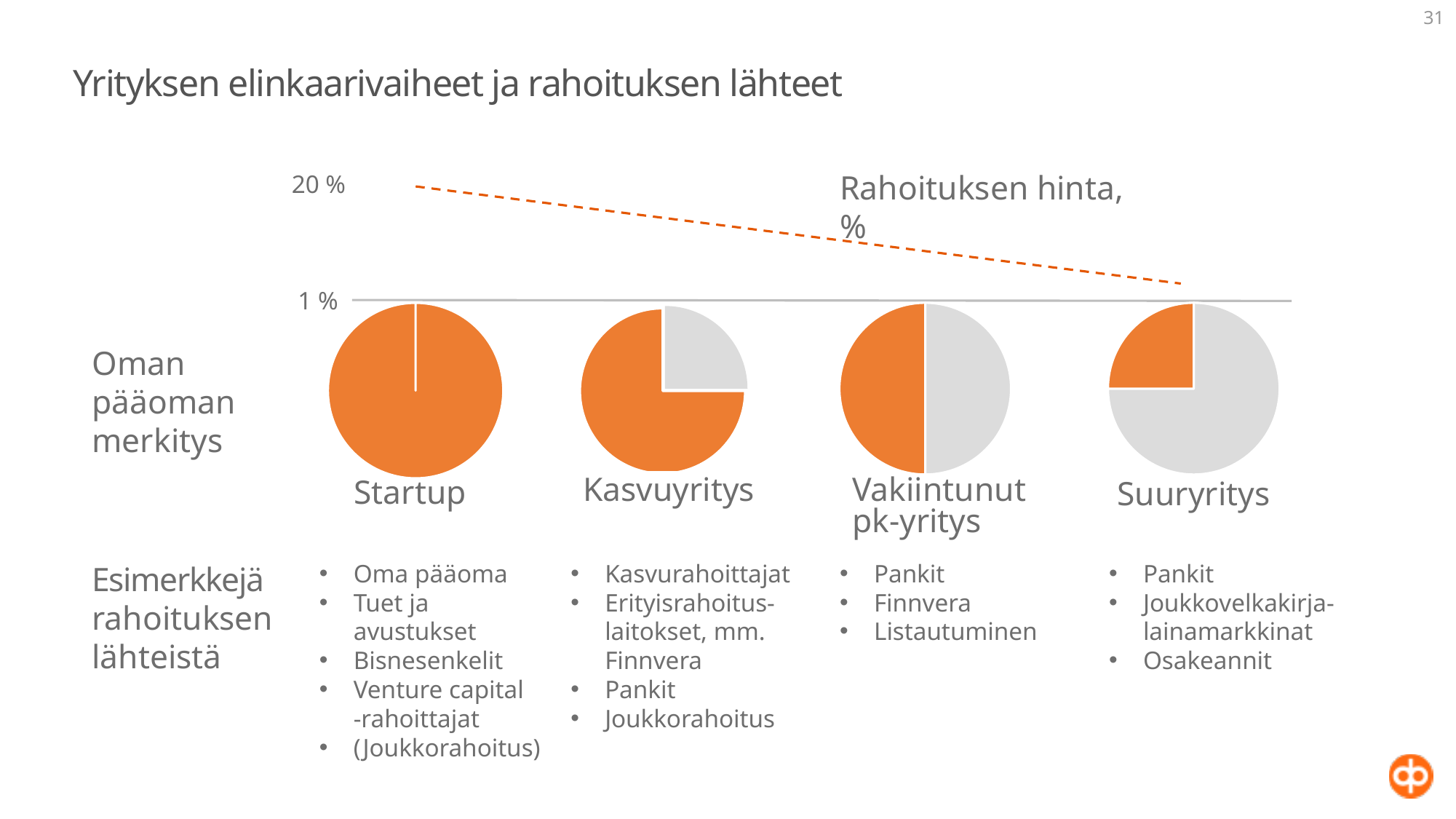
Does the dashed line labelled 'Rahoituksen hinta, %' rise or fall from left to right? Fall Which has a larger orange share in its pie chart, Suuryritys or Startup? Startup How many pie charts are shown on the slide? 4 What are the two percentage labels shown on the left of the dashed 'Rahoituksen hinta' line? 20 % and 1 % Is the orange share of the Suuryritys pie chart greater or less than half of the pie? less Is the orange share of the Kasvuyritys pie chart greater or less than half of the pie? greater What is the label of the third pie chart from the left? Vakiintunut pk-yritys Which has a larger orange share in its pie chart, Kasvuyritys or Vakiintunut pk-yritys? Kasvuyritys Which pie chart has the largest orange (own equity) share? Startup What kind of charts are shown under the heading 'Oman pääoman merkitys'? Pie charts Does the orange share of the pie charts rise or fall moving from Startup to Suuryritys? Fall Which pie chart has the smallest orange (own equity) share? Suuryritys